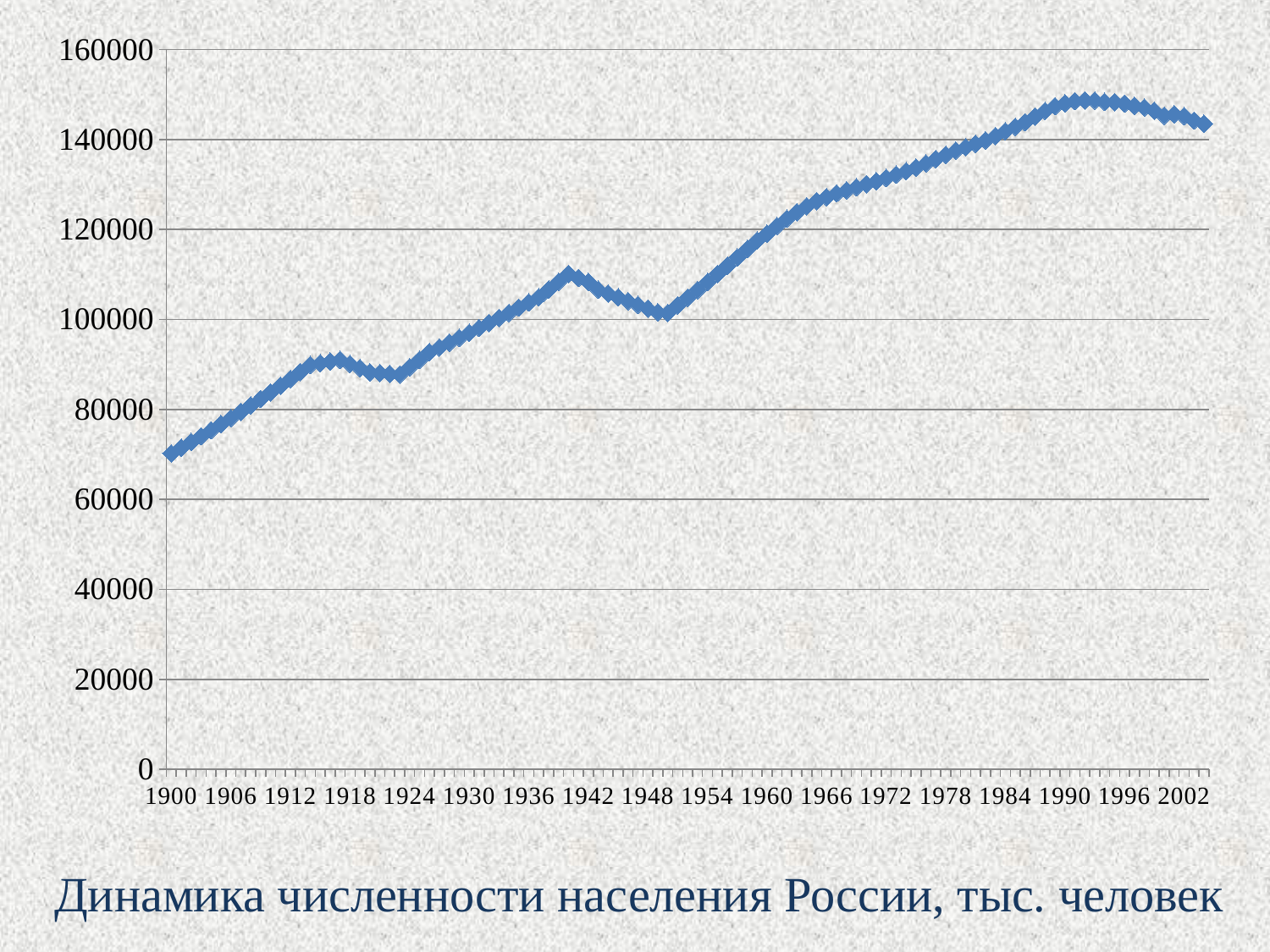
What kind of chart is shown on the slide? line chart Which labelled year on the x axis has the lowest value? 1900 Is the value for 1900 greater or less than 80000? less What is the title of the chart? Динамика численности населения России, тыс. человек Is the value for 1942 greater or less than 100000? greater Is the value for 1924 greater or less than 100000? less In what units are the values on the chart given, according to the title? тыс. человек Does the line rise or fall between 1954 and 1990? rises Does the line rise or fall between 1996 and 2002? falls